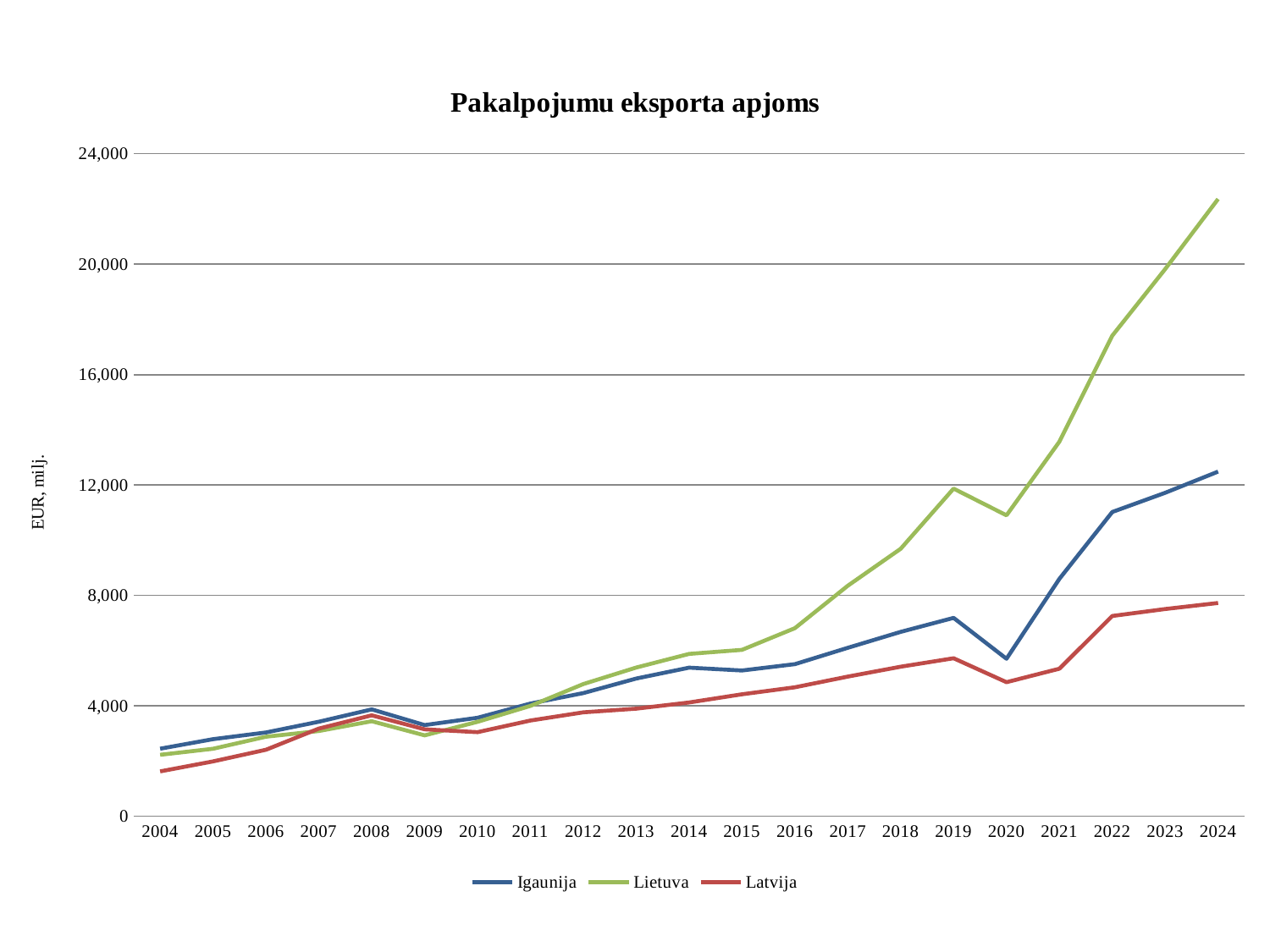
In 2020, which is larger: the value for Igaunija or the value for Latvija? Igaunija Is the value for Latvija in 2024 greater or less than 8,000? less Which series has the lowest value in 2024? Latvija What is the label on the y axis? EUR, milj. How many series does the legend list? 3 Does the Lietuva series generally rise or fall from 2004 to 2024? rise What is the title of the chart? Pakalpojumu eksporta apjoms How many years are plotted along the x axis? 21 Which series has the highest value in 2024? Lietuva Is the value for Lietuva in 2024 greater or less than 20,000? greater Is the value for Igaunija in 2024 greater or less than 8,000? greater What kind of chart is shown on the slide? line chart